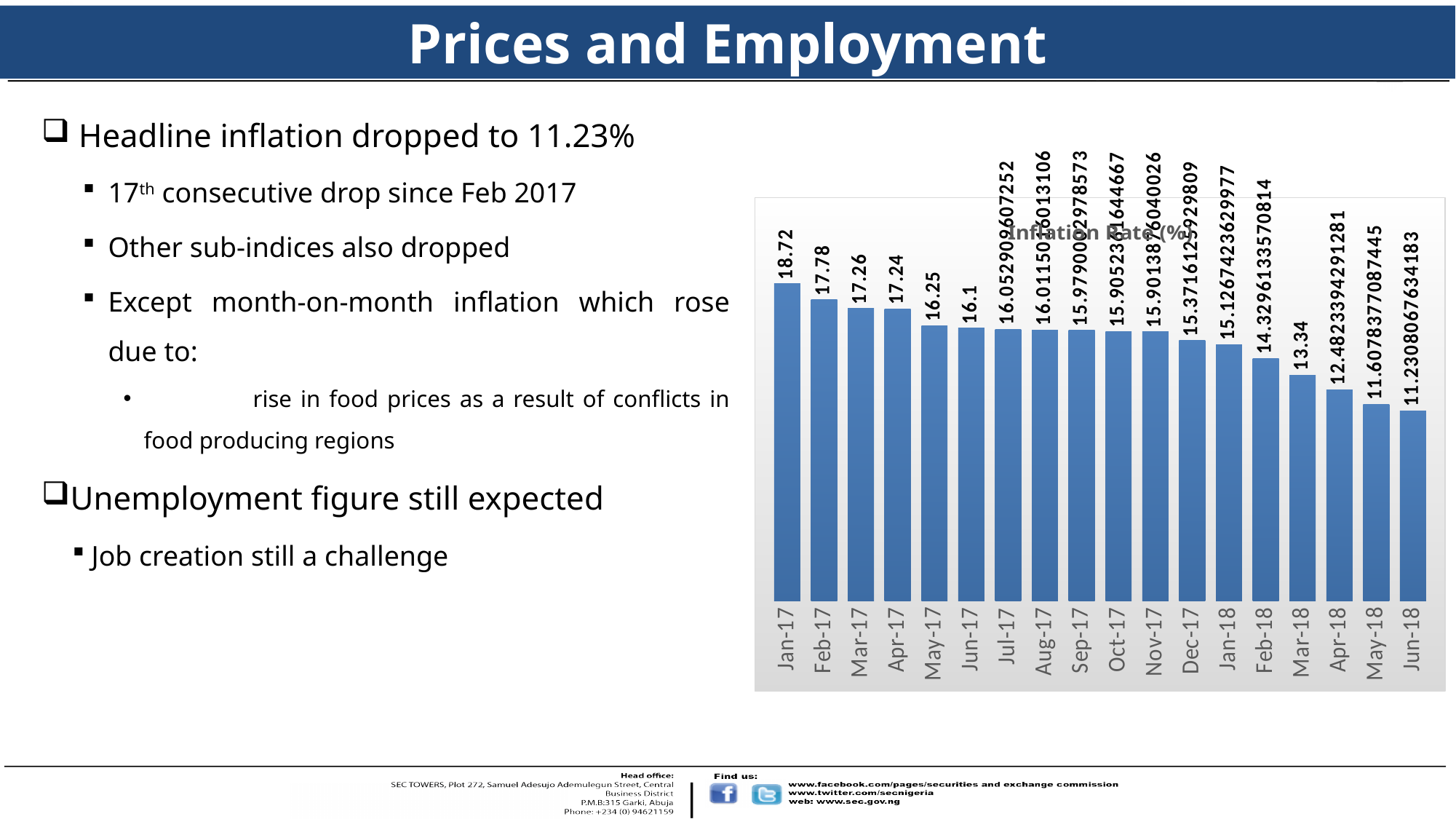
What is the difference between the inflation rates for Jan-17 and Mar-18? 5.38 What is the inflation rate for Jun-17? 16.1 How many months are plotted in the chart? 18 Which is larger, the inflation rate for Feb-17 or for Mar-17? Feb-17 What is the inflation rate for Mar-18? 13.34 Which month has the lowest inflation rate? Jun-18 What is the inflation rate for Jan-17? 18.72 Do the inflation rate values rise or fall from Jan-17 to Jun-18? Fall Which month has the highest inflation rate? Jan-17 What is the difference between the inflation rates for Jan-17 and Feb-17? 0.94 What type of chart is shown on the slide? Bar chart What is the title of the chart? Inflation Rate (%)